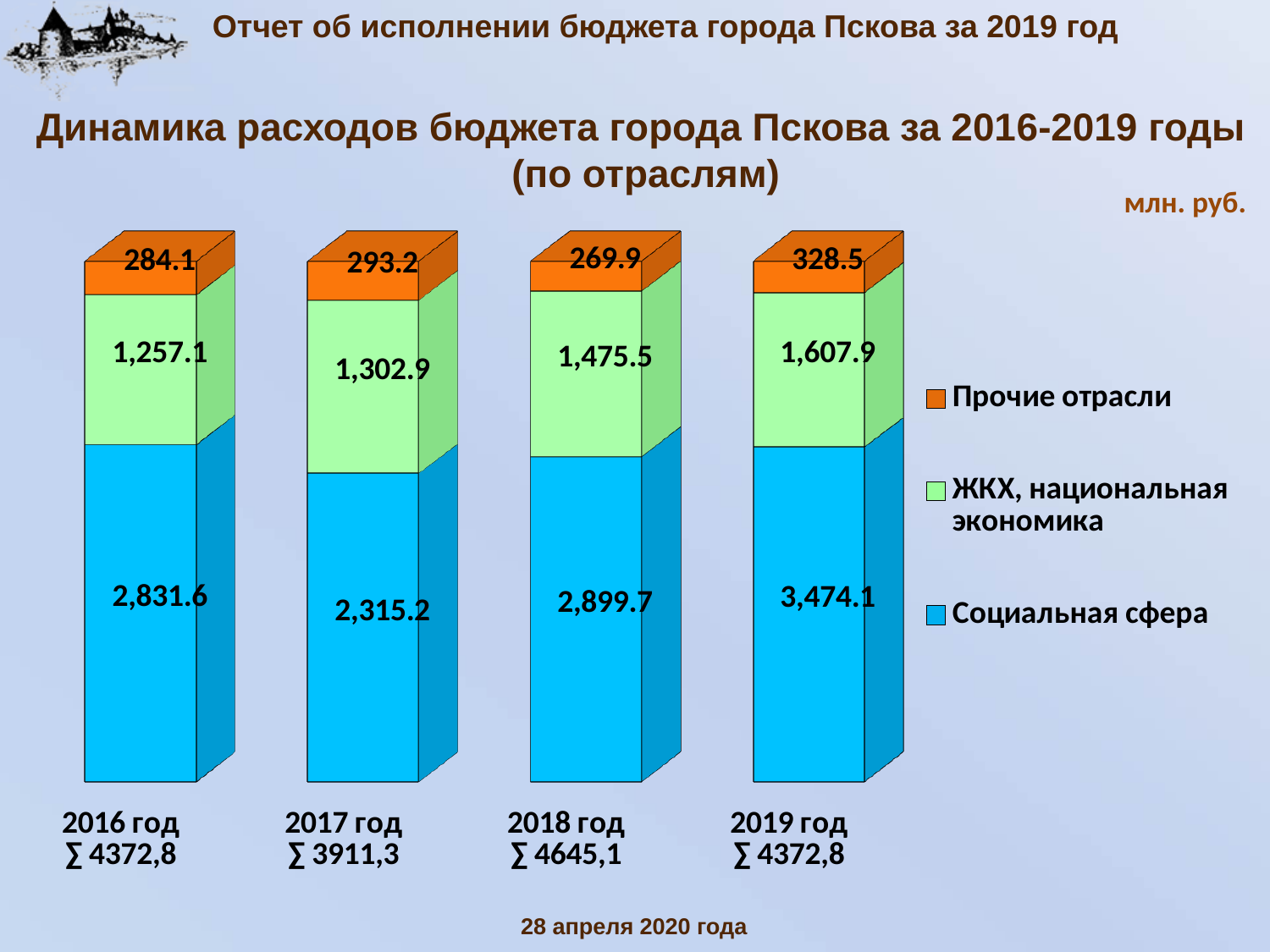
How many series does the legend list? 3 Which year has the larger value for Прочие отрасли, 2016 год or 2017 год? 2017 год What is the value for ЖКХ, национальная экономика in 2017 год? 1,302.9 In which year is the value for Прочие отрасли the lowest? 2018 год What kind of chart is shown on the slide? Stacked bar chart How many years are shown on the x axis of the chart? 4 In which year is the value for Социальная сфера the highest? 2019 год What is the value for Прочие отрасли in 2018 год? 269.9 Does the value for ЖКХ, национальная экономика rise or fall from 2016 год to 2019 год? Rises What is the total of the stacked bar for 2017 год? 3911,3 What is the value for Социальная сфера in 2019 год? 3,474.1 What is the difference between the Социальная сфера values for 2019 год and 2018 год? 574.4